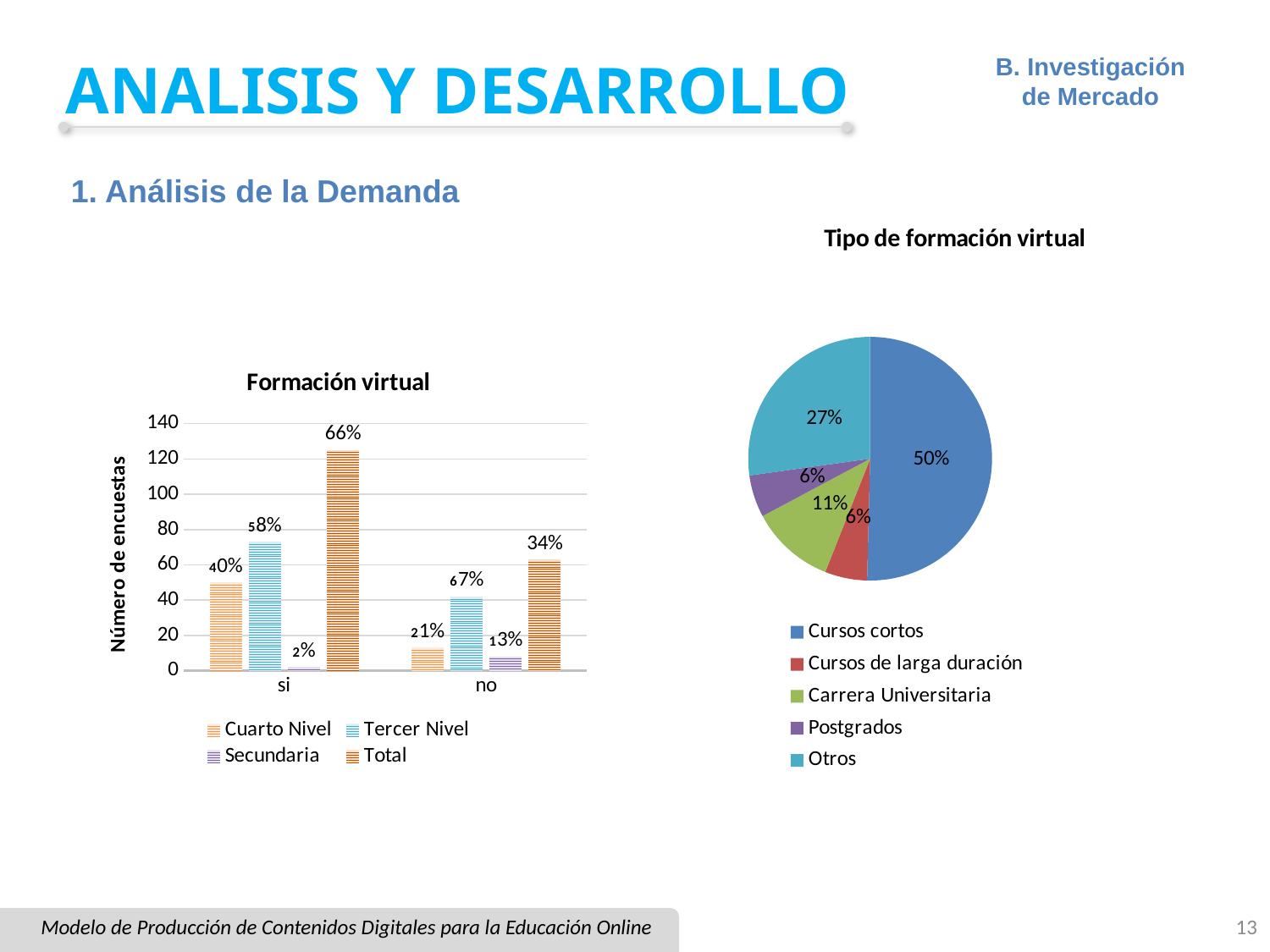
In the 'Formación virtual' bar chart, what data label is shown on the Total bar for 'si'? 66% In the 'Formación virtual' bar chart, which bar is taller: Tercer Nivel for 'si' or Tercer Nivel for 'no'? Tercer Nivel for 'si' In the 'Formación virtual' bar chart, is the Total bar for 'si' greater or less than 120 on the y axis? greater In the 'Formación virtual' bar chart, what data label is shown on the Tercer Nivel bar for 'no'? 67% In the 'Formación virtual' bar chart, what is the y-axis title? Número de encuestas In the 'Tipo de formación virtual' pie chart, which category has the largest slice? Cursos cortos In the 'Formación virtual' bar chart, is the Cuarto Nivel bar for 'no' greater or less than 20 on the y axis? less What kind of chart is 'Tipo de formación virtual'? Pie chart In the 'Tipo de formación virtual' pie chart, what share does Otros have? 27% In the 'Tipo de formación virtual' pie chart, what share does Cursos cortos have? 50% In the 'Formación virtual' bar chart, what data label is shown on the Secundaria bar for 'si'? 2% In the 'Formación virtual' bar chart, how many series does the legend list? 4